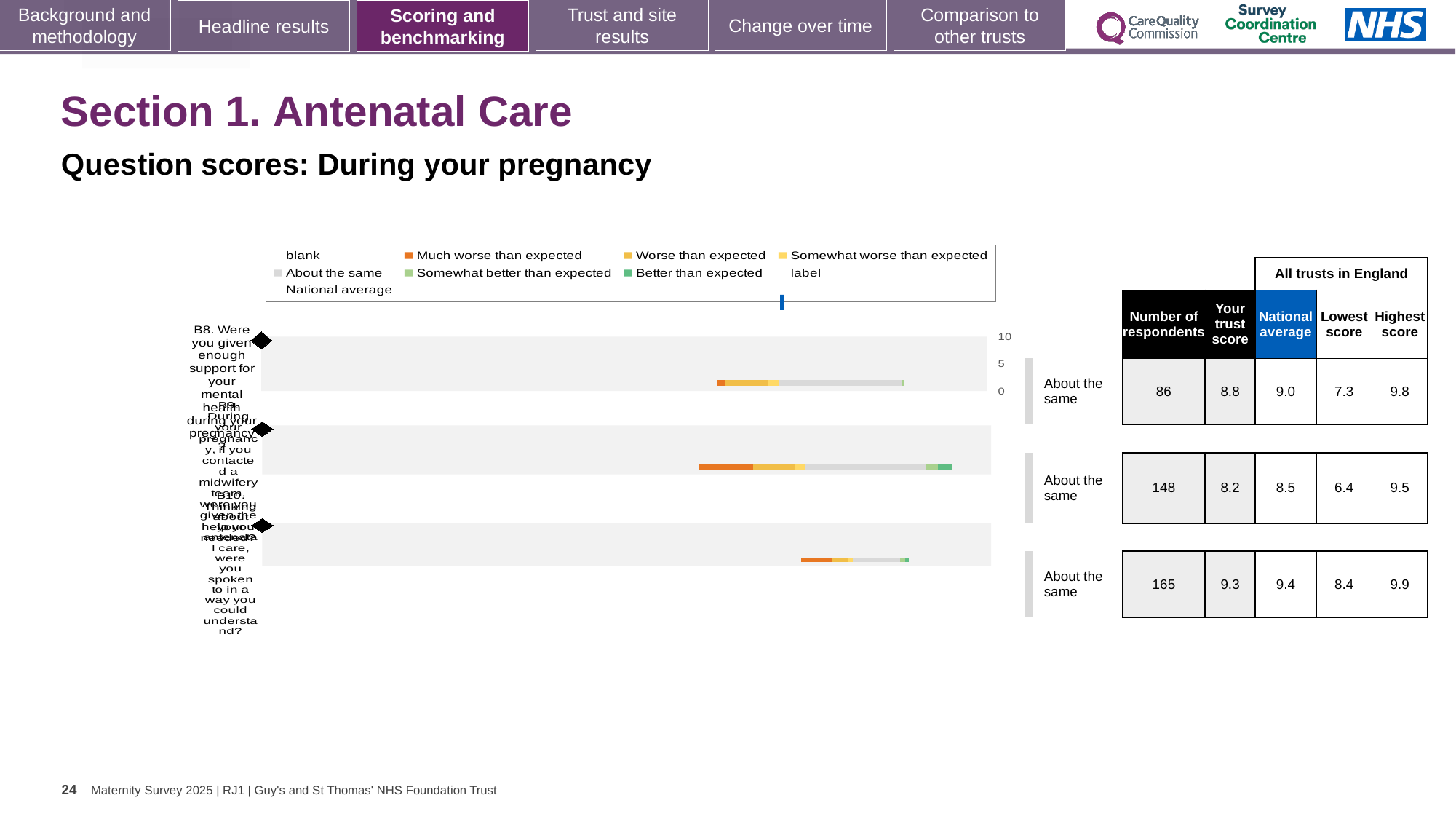
How many question rows are plotted in the chart? 3 Which row of the chart has the highest number of respondents? The third row (165) What is the difference between the highest score and the lowest score for the first row (B8)? 2.5 What is the trust score for the first row (B8) of the chart? 8.8 What is the difference between the national average and the trust score for the second row of the chart? 0.3 What benchmark category is shown for the third row of the chart? About the same For the first row (B8), which is larger: the trust score or the national average? National average What kind of chart is shown on the slide? Bar chart What is the national average for the first row (B8) of the chart? 9.0 What is the highest score among all trusts in England for the third row of the chart? 9.9 What is the lowest score among all trusts in England for the second row of the chart? 6.4 How many respondents are shown for question B8 (the first row of the chart)? 86